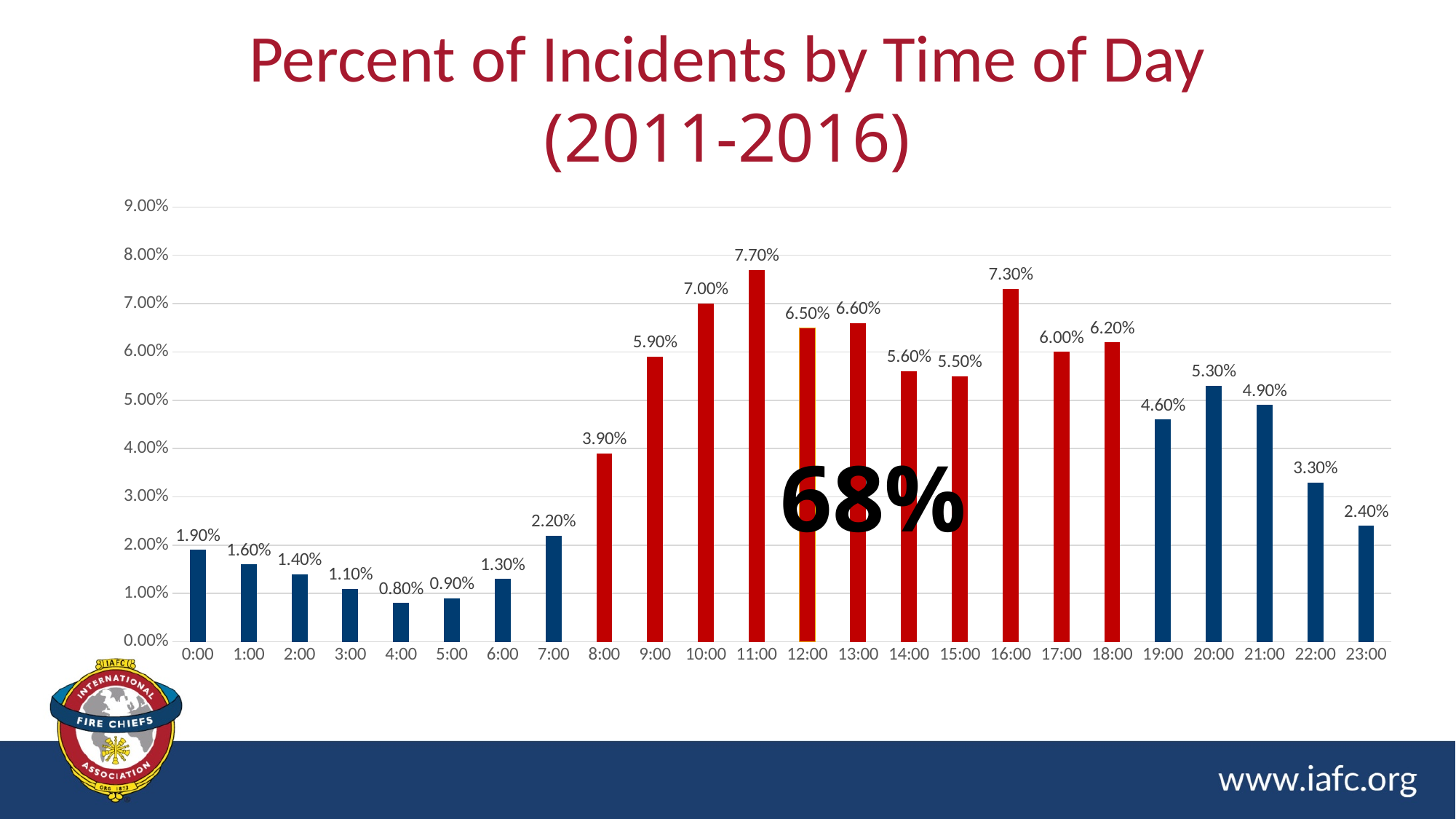
What kind of chart is shown on the slide? Bar chart What large percentage is printed over the red bars in the middle of the chart? 68% What is the percent of incidents at 20:00? 5.30% How many time-of-day categories are shown on the x axis? 24 Which time of day has the highest percent of incidents? 11:00 Which time of day has the lowest percent of incidents? 4:00 What is the percent of incidents at 4:00? 0.80% What is the percent of incidents at 11:00? 7.70% Do the values rise or fall from 0:00 to 4:00? Fall What is the difference between the percent of incidents at 16:00 and at 8:00? 3.40% Which has a higher percent of incidents, 13:00 or 18:00? 13:00 Is the value for 9:00 greater or less than 5.00%? greater